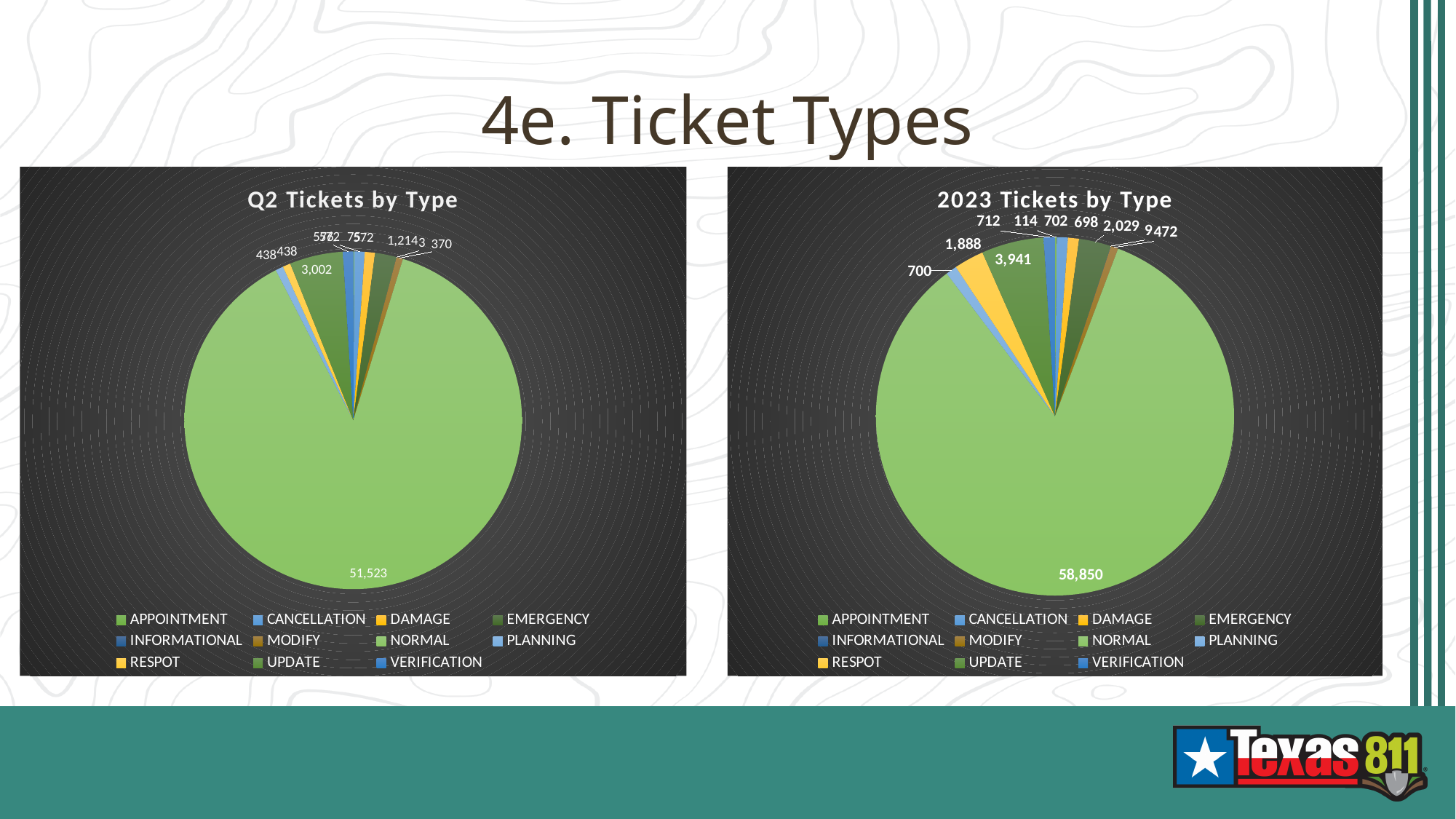
How much larger is the NORMAL value in the "2023 Tickets by Type" chart than in the "Q2 Tickets by Type" chart? 7,327 In the "Q2 Tickets by Type" chart, which ticket type has the largest slice? NORMAL How many ticket types does the legend of the "2023 Tickets by Type" chart list? 11 In the "2023 Tickets by Type" chart, what is the value shown for NORMAL tickets? 58,850 In the "Q2 Tickets by Type" chart, what is the value shown for NORMAL tickets? 51,523 In the "2023 Tickets by Type" chart, what is the value shown for UPDATE tickets? 3,941 In the "2023 Tickets by Type" chart, what is the value shown for RESPOT tickets? 1,888 In the "2023 Tickets by Type" chart, which ticket type has the largest slice? NORMAL In the "Q2 Tickets by Type" chart, what is the value shown for UPDATE tickets? 3,002 What kind of chart is the "Q2 Tickets by Type" chart? Pie chart Which chart shows the larger value for UPDATE tickets, "Q2 Tickets by Type" or "2023 Tickets by Type"? 2023 Tickets by Type In the "2023 Tickets by Type" chart, what is the value shown for PLANNING tickets? 700